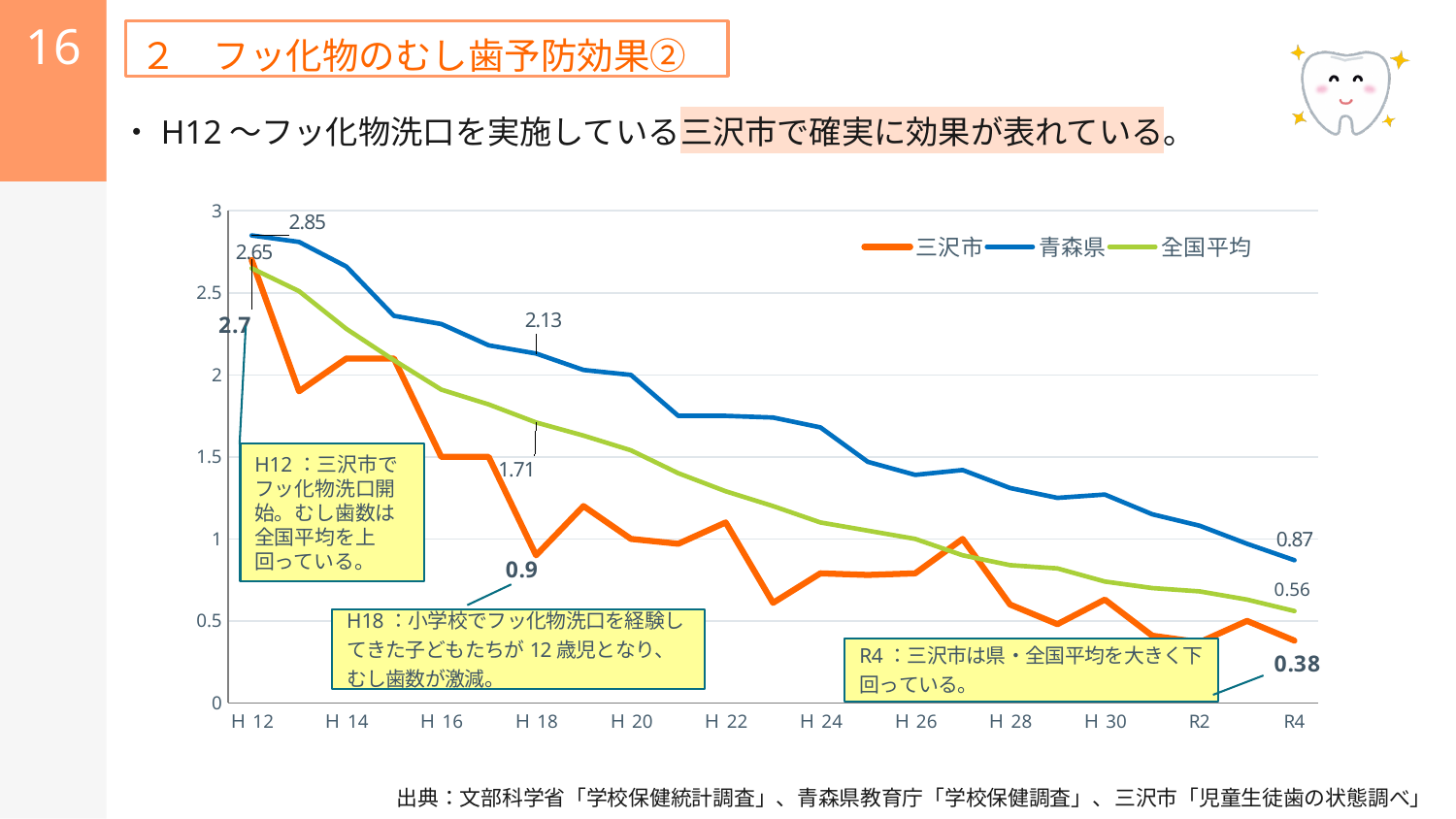
How many series does the chart legend list? 3 What is the value for 青森県 at H12? 2.85 Do the values for 青森県 rise or fall from H12 to R4? fall What is the difference between 青森県 and 三沢市 at R4? 0.49 At H18, which is larger: the value for 全国平均 or the value for 三沢市? 全国平均 What is the value for 全国平均 at H18? 1.71 What is the value for 青森県 at R4? 0.87 What is the value for 三沢市 at R4? 0.38 What is the value for 三沢市 at H12? 2.7 Which series has the lowest value at R4? 三沢市 What is the difference between 青森県 and 三沢市 at H18? 1.23 What type of chart is shown on the slide? line chart